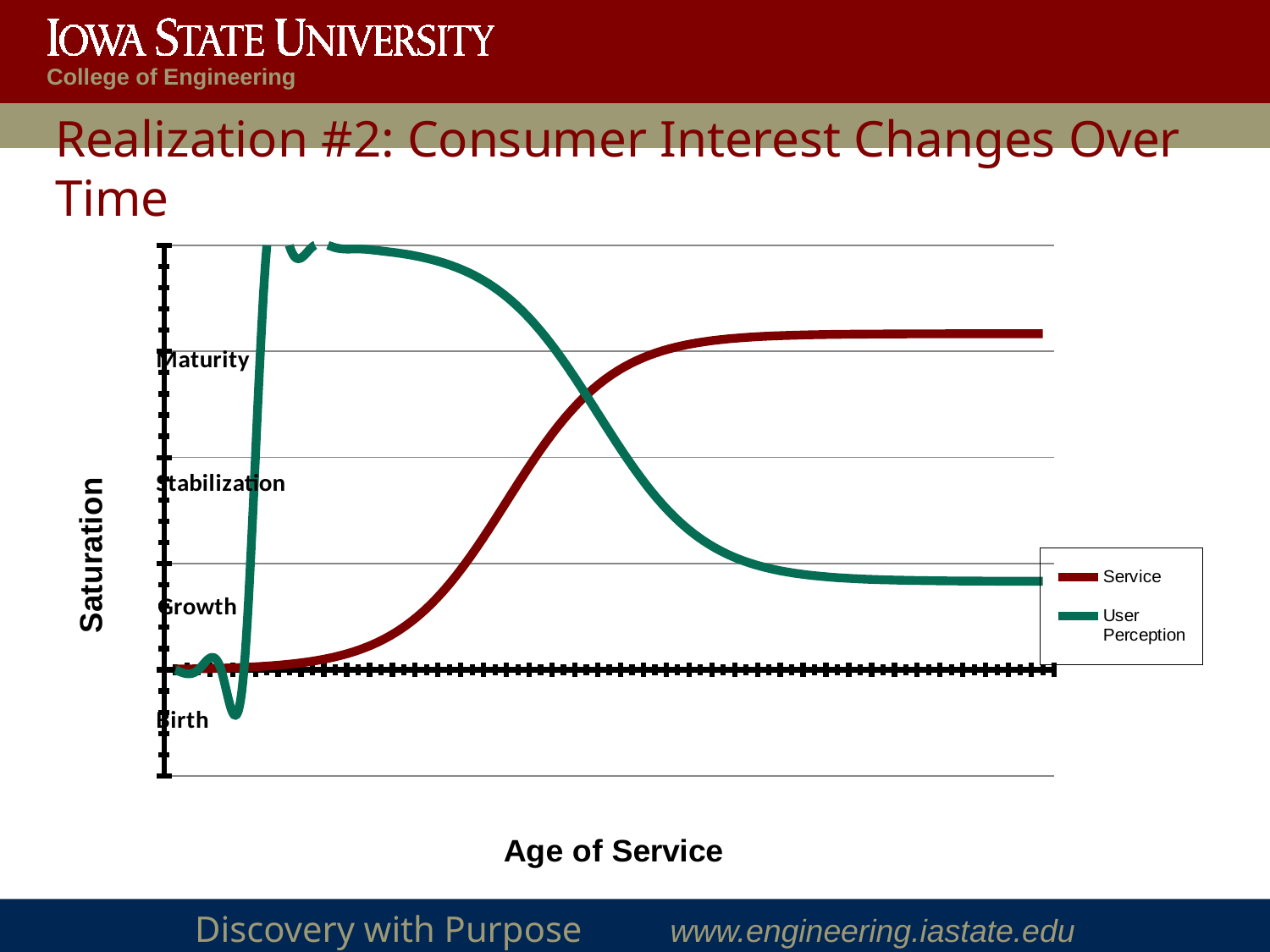
How many series does the chart's legend list? 2 Which series ends at the lowest saturation level at the right end of the chart? User Perception At the right end of the chart, which series is higher: Service or User Perception? Service What are the two series named in the chart's legend? Service and User Perception What is the title of the chart's x axis? Age of Service Near the start of the Age of Service axis, which series reaches a higher saturation: Service or User Perception? User Perception Which series peaks at the highest saturation level on the chart? User Perception What kind of chart is shown on the slide? line chart Does the Service series level off above or below the Maturity line at the right end of the chart? above Which stage label on the Saturation axis is the lowest? Birth Does the Service series rise or fall as Age of Service increases? rises Does the User Perception series rise or fall over the later part of the Age of Service axis? falls